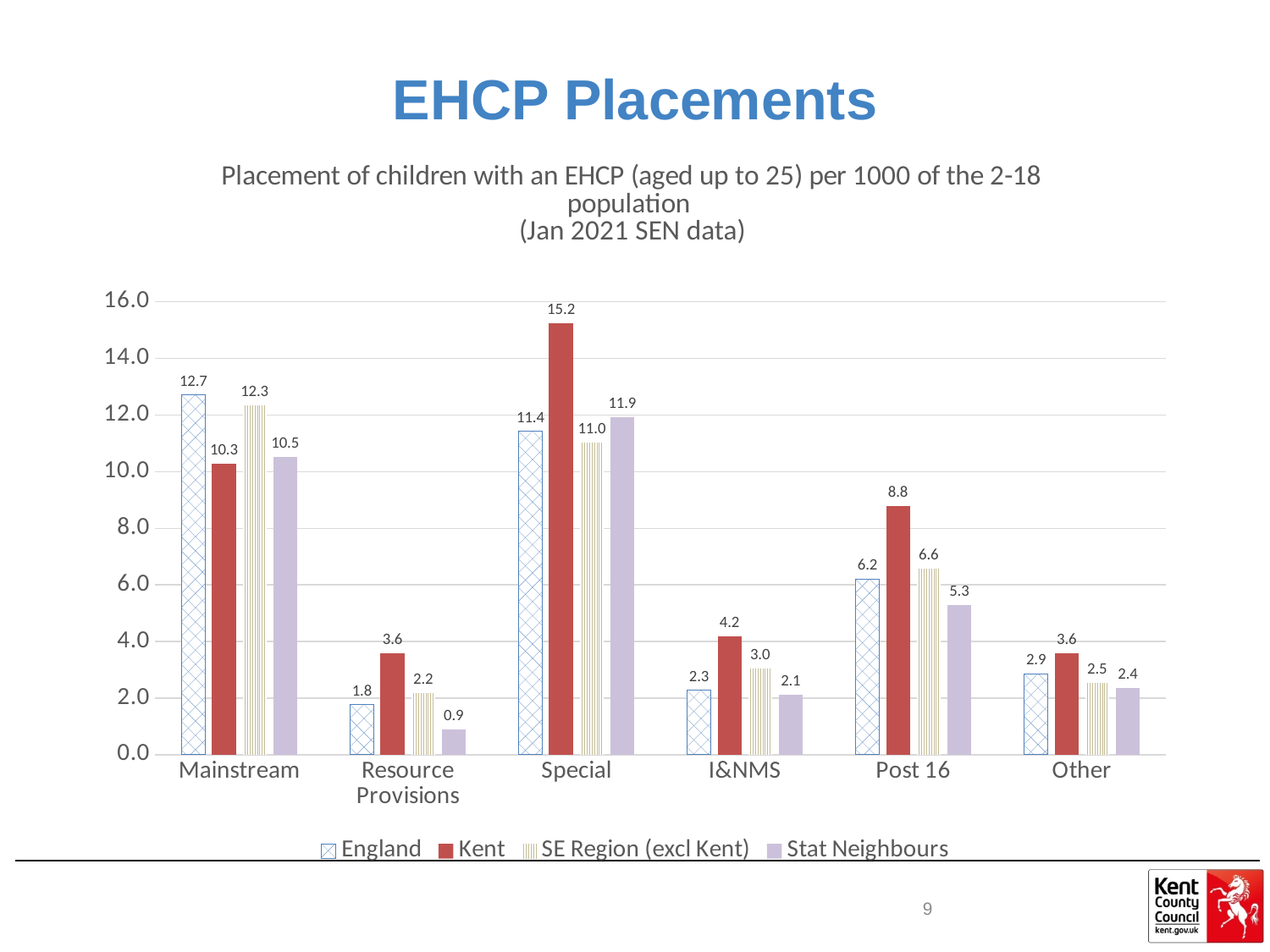
What is the value for England in the Mainstream category? 12.7 What is the value for Kent in the Special category? 15.2 Which series is shown in red in the legend? Kent What is the value for SE Region (excl Kent) in the Post 16 category? 6.6 Which category has the highest value for Kent? Special Which category has the lowest value for Stat Neighbours? Resource Provisions In the Mainstream category, which is larger: the England value or the Kent value? England What is the value for Stat Neighbours in the Resource Provisions category? 0.9 How many series does the legend list? 4 How many categories are shown on the x axis? 6 What kind of chart is shown on the slide? Bar chart What is the difference between the Kent and England values in the Special category? 3.8